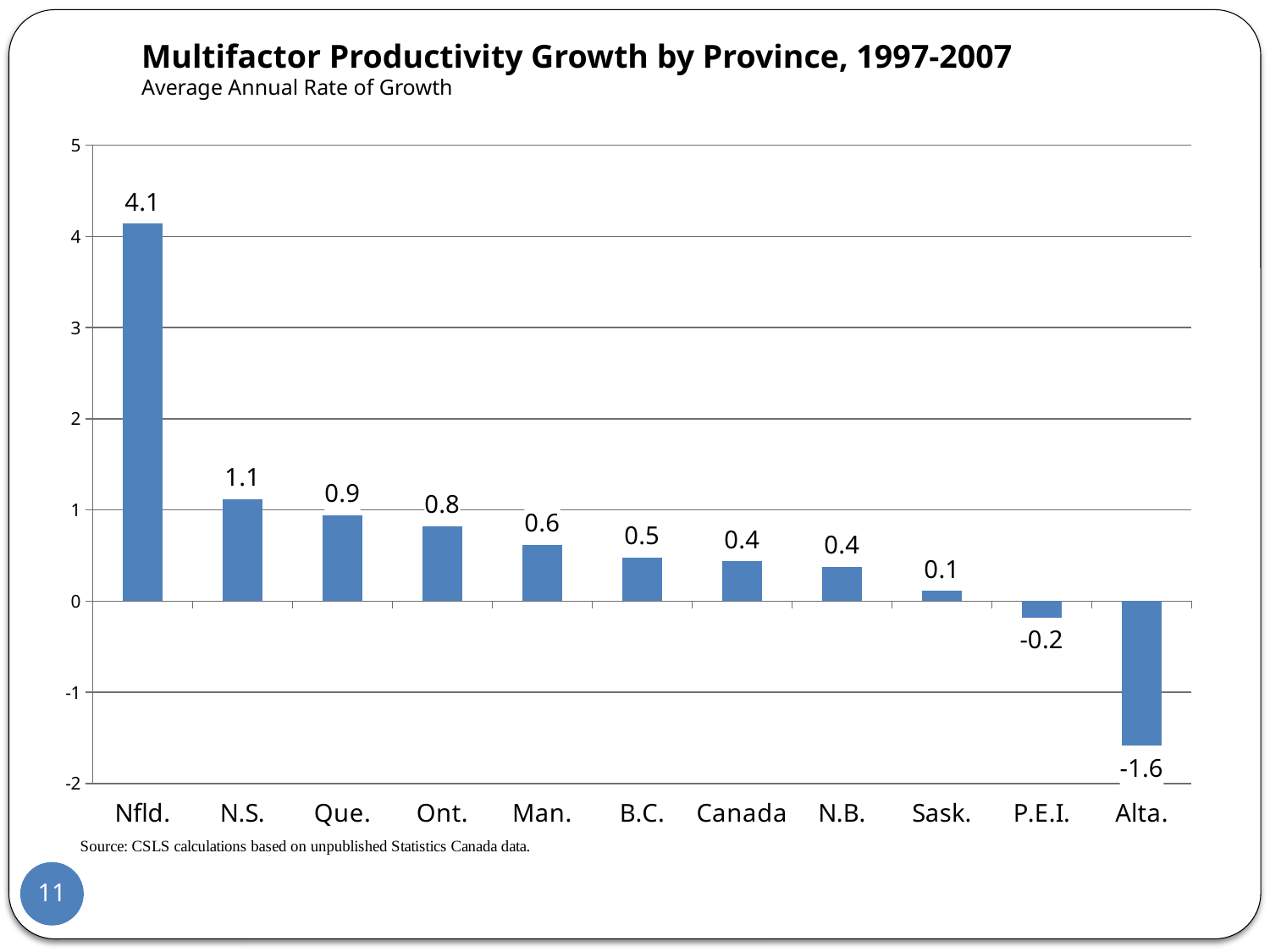
Is the value for Nfld. greater or less than 4? greater Which province has the highest multifactor productivity growth? Nfld. Which has a higher value, Que. or Ont.? Que. What kind of chart is shown on the slide? Bar chart Which category has the lowest value on the chart? Alta. What value is shown for P.E.I.? -0.2 What is the average annual multifactor productivity growth rate shown for Nfld.? 4.1 How many categories are shown on the x axis? 11 What value is shown for Canada? 0.4 What is the title of the chart? Multifactor Productivity Growth by Province, 1997-2007 What is the difference between the values for Nfld. and N.S.? 3.0 What value is shown for Alta.? -1.6